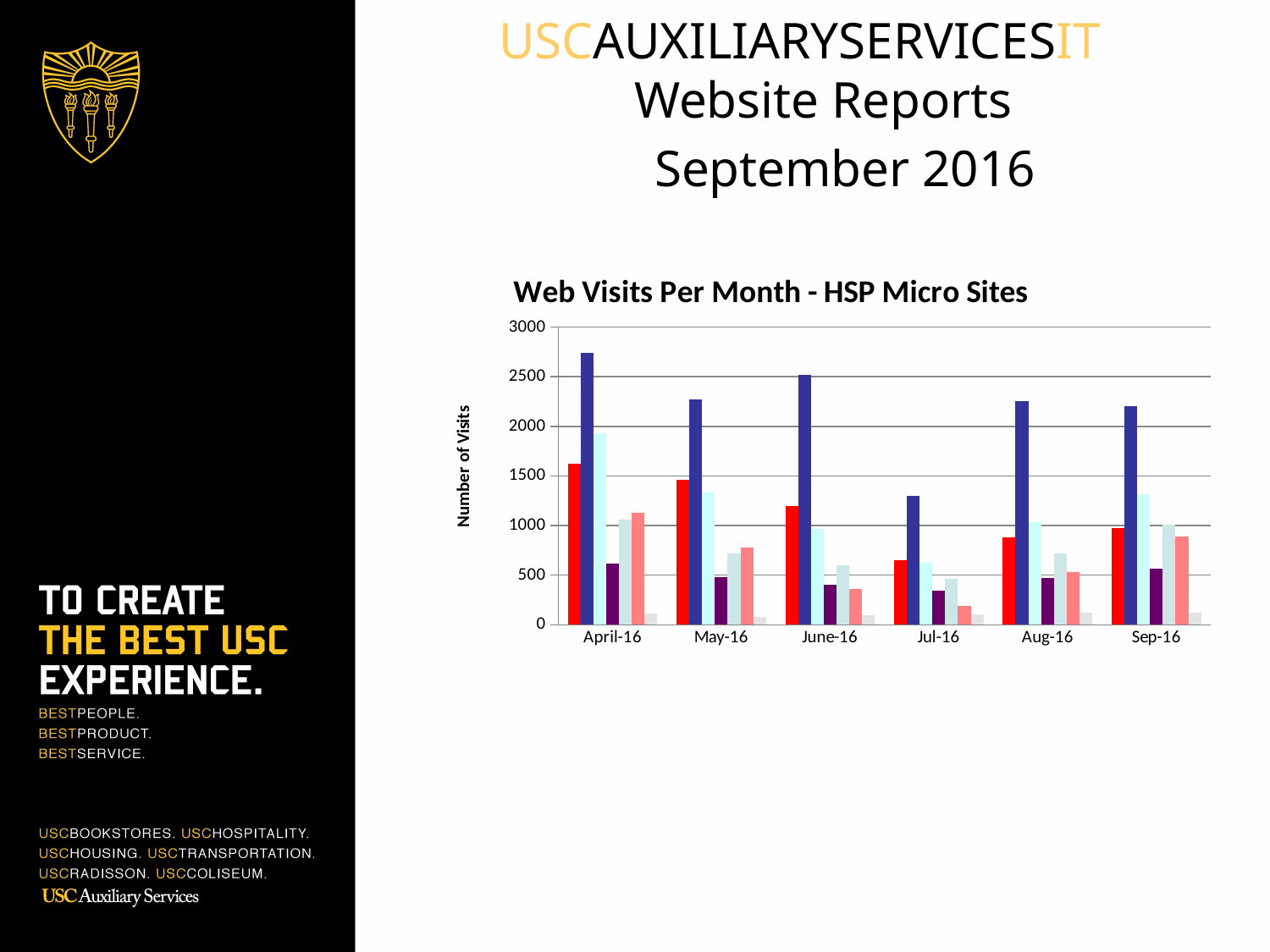
In which month is the red bar the tallest? April-16 In which month is the red bar the shortest? Jul-16 In April-16, which is larger, the red bar or the dark blue bar? the dark blue bar Do the red bars rise or fall from April-16 to Jul-16? fall Is the dark blue bar for April-16 greater or less than 2500? greater What is the label on the vertical axis of the chart? Number of Visits Is the red bar for Jul-16 greater or less than 1000? less In which month is the dark blue bar the tallest? April-16 What kind of chart is shown on the slide? bar chart In which month is the dark blue bar the shortest? Jul-16 How many months are shown on the x axis of the chart? 6 What is the title of the chart? Web Visits Per Month - HSP Micro Sites